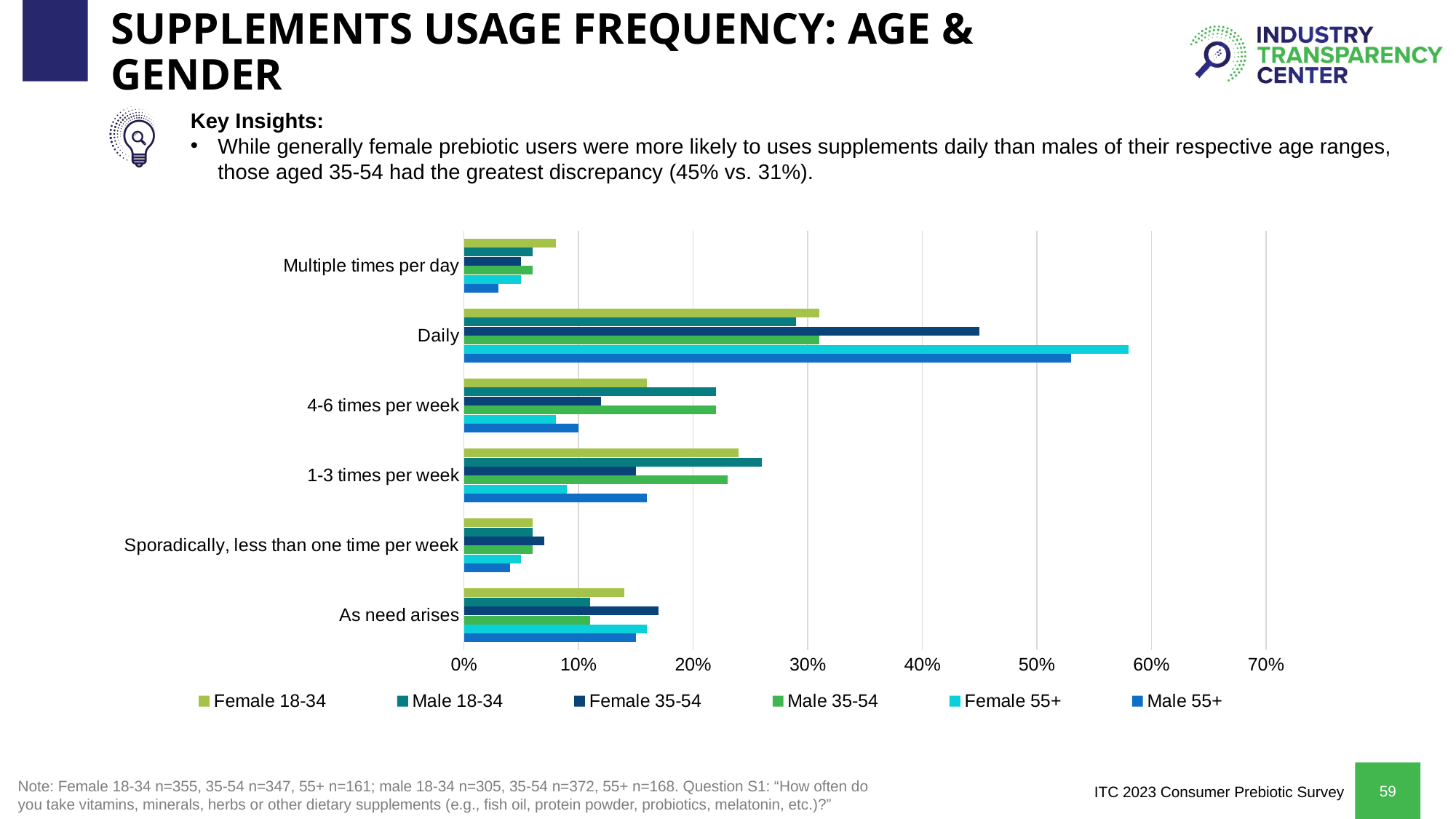
Is the value for Female 18-34 in the 1-3 times per week category greater or less than 20%? greater According to the slide, what share of Female 35-54 prebiotic users take supplements daily? 45% How many usage-frequency categories are plotted on the chart? 6 What kind of chart is shown on the slide? bar chart Is the value for Female 55+ in the Daily category greater or less than 50%? greater According to the slide, what share of Male 35-54 prebiotic users take supplements daily? 31% For the 4-6 times per week category, which is larger: Male 18-34 or Female 35-54? Male 18-34 Which usage-frequency category has the longest bar on the chart? Daily Is the value for Male 55+ in the Multiple times per day category greater or less than 10%? less Which series has the highest value for the Daily category? Female 55+ How many series does the chart legend list? 6 For the Daily category, which is larger: Female 55+ or Male 55+? Female 55+